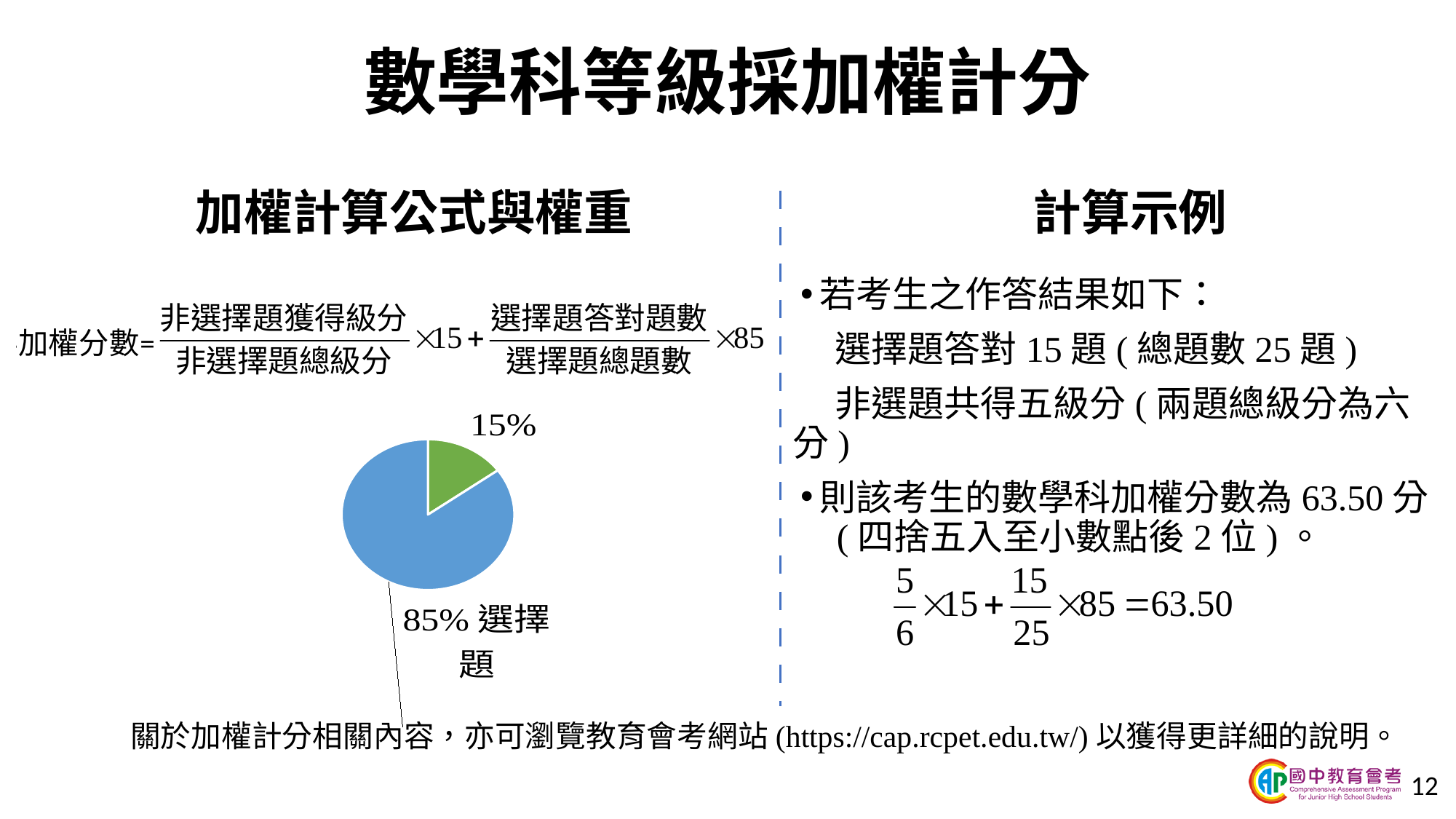
What colour is the 15% slice in the pie chart? green What share of the pie chart does 選擇題 take? 85% How many slices does the pie chart have? 2 What is the total of the two slice percentages in the pie chart? 100% What colour is the 選擇題 slice in the pie chart? blue Is the share for 選擇題 greater or less than 50%? greater What percentage is shown for the smaller slice of the pie chart? 15% What is the difference in percentage points between the 85% slice and the 15% slice? 70 Which slice of the pie chart is the largest? 選擇題 Is the 選擇題 slice larger or smaller than the 15% slice? larger What kind of chart is shown on the slide? pie chart